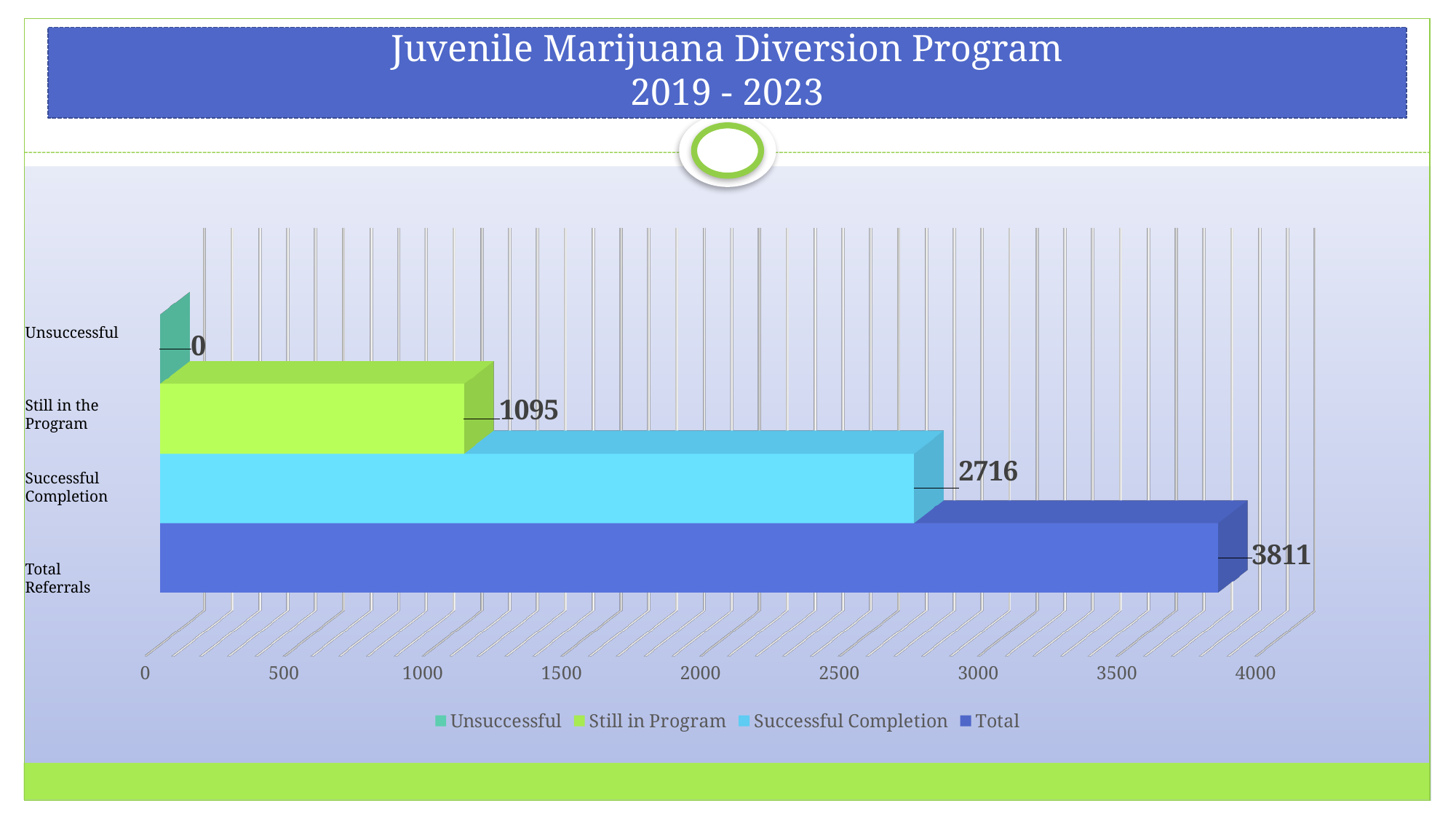
What is the value for Still in the Program? 1095 How many categories are shown on the chart? 4 What is the value for Successful Completion? 2716 What is the value for Total Referrals? 3811 What kind of chart is shown on the slide? Bar chart Which is larger, Successful Completion or Still in the Program? Successful Completion What is the difference between Successful Completion and Still in the Program? 1621 How many entries does the legend list? 4 Which category has the lowest value? Unsuccessful Which category has the highest value? Total Referrals What is the value for Unsuccessful? 0 What is the difference between Total Referrals and Successful Completion? 1095